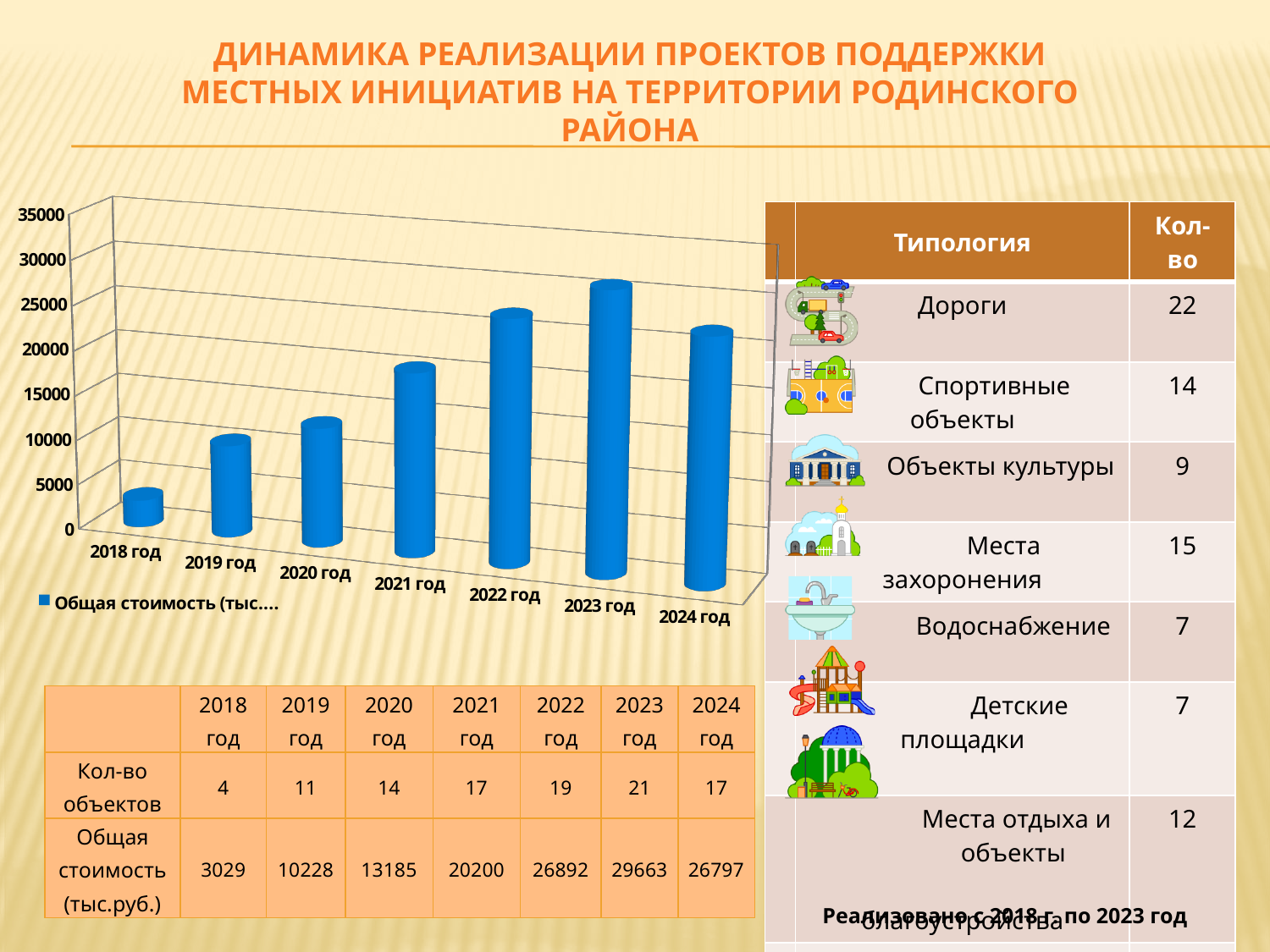
Using the values in the table under the chart, what is the difference in Общая стоимость between 2023 год and 2024 год? 2866 Is the bar for 2020 год greater or less than 10000? greater According to the table under the chart, what is the Общая стоимость (тыс.руб.) for 2023 год? 29663 How many years (categories) are plotted on the chart's x axis? 7 Which year has the tallest bar on the chart? 2023 год Which bar is taller, 2021 год or 2022 год? 2022 год Which year has the shortest bar on the chart? 2018 год Is the bar for 2023 год greater or less than 25000? greater What kind of chart is shown on the slide? bar chart How many series does the chart legend list? 1 Is the bar for 2018 год greater or less than 5000? less Do the bars rise or fall from 2018 год to 2023 год? rise